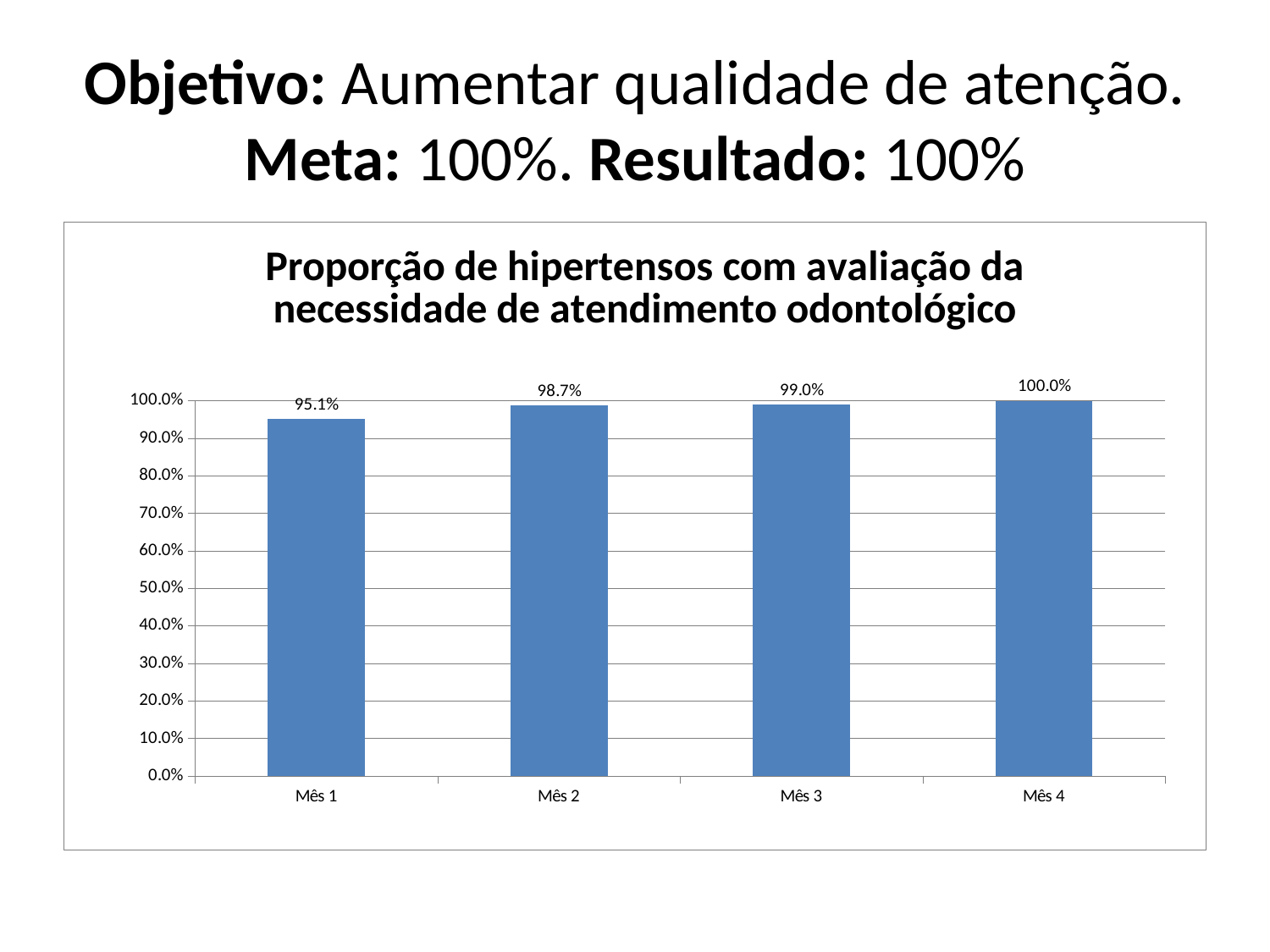
What kind of chart is shown? Bar chart What is the value for Mês 4? 100.0% Which month has the highest value? Mês 4 What is the difference between the values for Mês 4 and Mês 1? 4.9% What is the value for Mês 2? 98.7% How many months are shown on the x axis? 4 What is the difference between the values for Mês 2 and Mês 1? 3.6% Which is larger, the value for Mês 1 or the value for Mês 2? Mês 2 What is the value for Mês 1? 95.1% Do the values rise or fall from Mês 1 to Mês 4? Rise Which month has the lowest value? Mês 1 What is the value for Mês 3? 99.0%